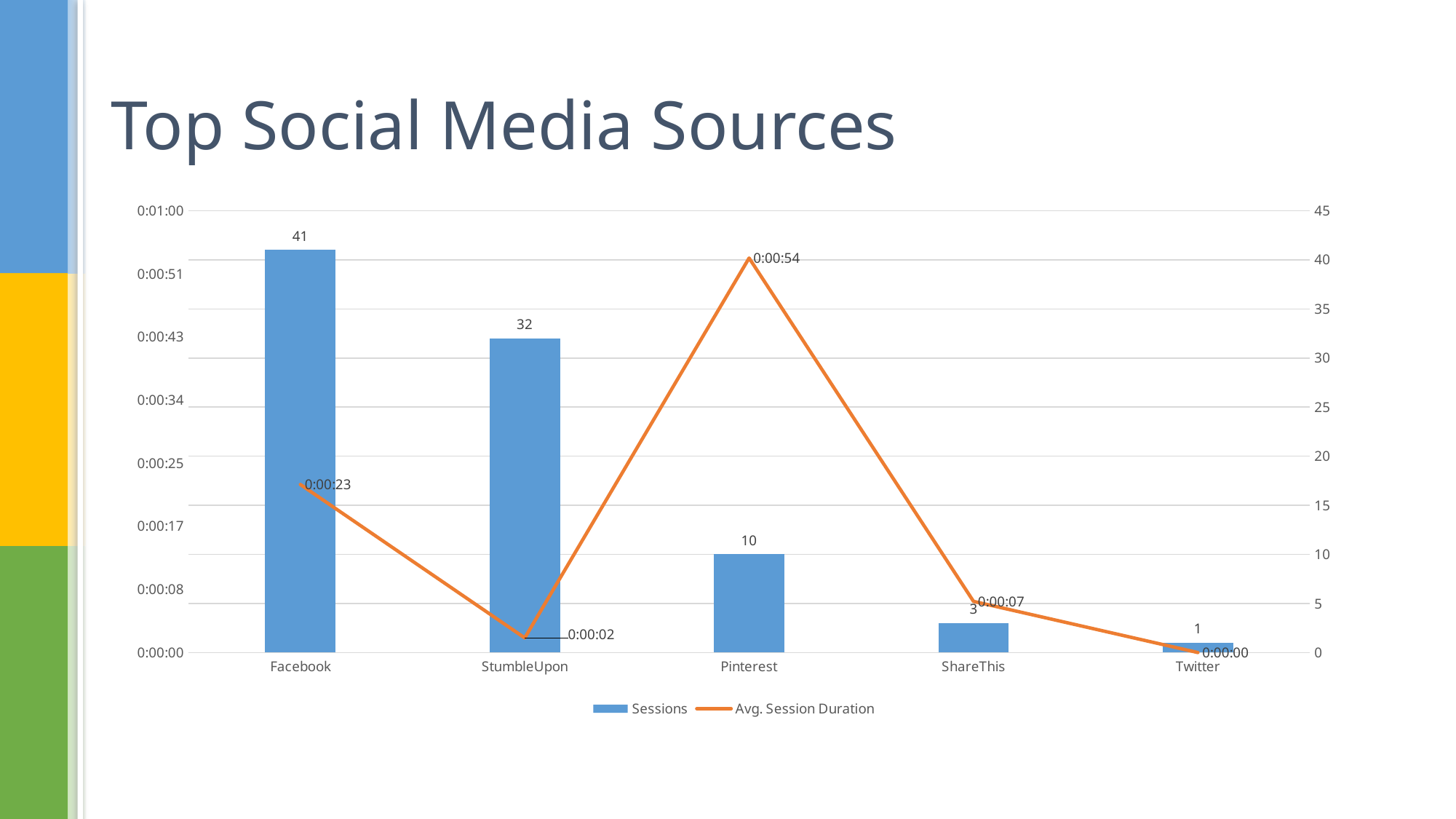
How many sessions came from Facebook? 41 What is the average session duration for Pinterest? 0:00:54 What is the difference in sessions between Facebook and StumbleUpon? 9 Which source has the longest average session duration? Pinterest How many social media sources are shown on the x axis? 5 Which source has the lowest number of sessions? Twitter Which source has the highest number of sessions? Facebook What is the title of the chart? Top Social Media Sources What is the average session duration for StumbleUpon? 0:00:02 How many sessions came from ShareThis? 3 Which has more sessions, Pinterest or ShareThis? Pinterest How many series does the legend list? 2